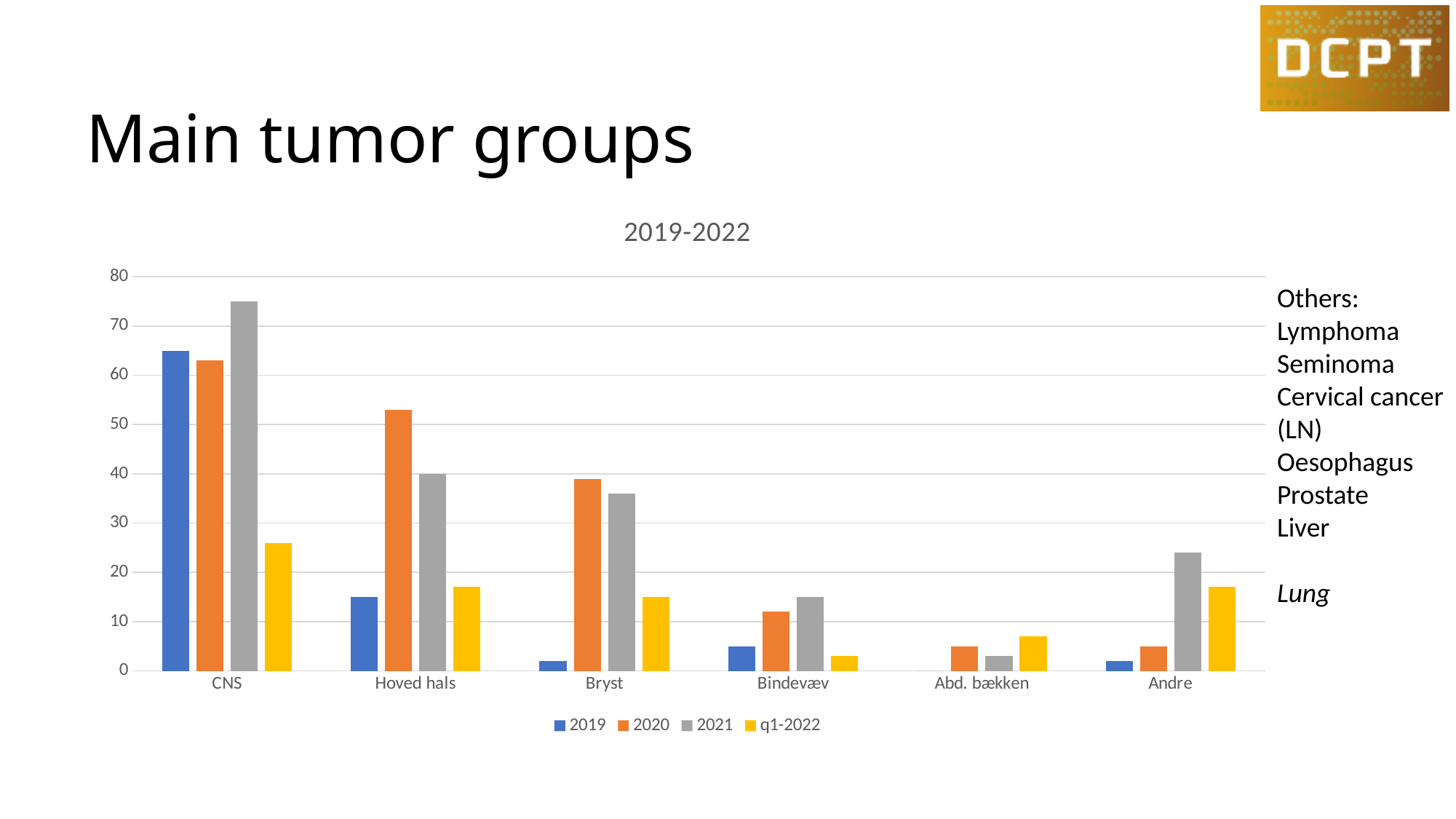
Which category has the highest value for the 2021 series? CNS What is the title of the chart? 2019-2022 What kind of chart is shown on the slide? bar chart Is the 2020 value for Hoved hals greater or less than 50? greater How many series does the legend list? 4 For CNS, which series has the larger value, 2019 or 2021? 2021 Is the 2021 value for Andre greater or less than 20? greater For Bryst, which series has the larger value, 2019 or 2020? 2020 Which category has the highest value for the q1-2022 series? CNS How many tumor group categories are shown on the x axis? 6 Is the 2021 value for CNS greater or less than 70? greater